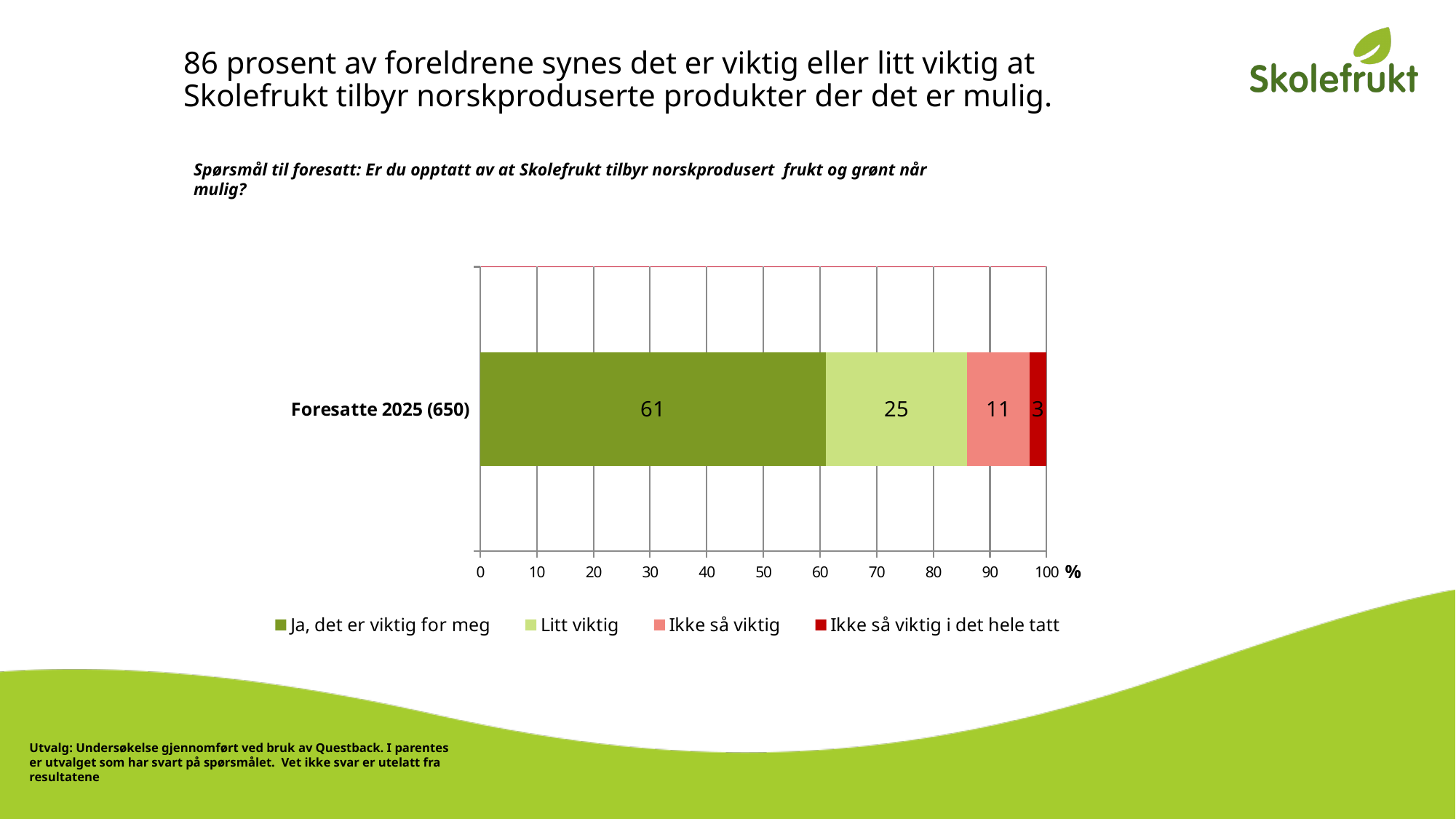
Which series has the lowest value in the Foresatte 2025 (650) bar? Ikke så viktig i det hele tatt What is the value for "Ikke så viktig i det hele tatt" for Foresatte 2025 (650)? 3 What is the total of the stacked bar for Foresatte 2025 (650)? 100 Which series has the highest value in the Foresatte 2025 (650) bar? Ja, det er viktig for meg What is the value for "Ja, det er viktig for meg" for Foresatte 2025 (650)? 61 What is the value for "Litt viktig" for Foresatte 2025 (650)? 25 What is the difference between the values for "Ja, det er viktig for meg" and "Litt viktig"? 36 What kind of chart is shown on the slide? Stacked bar chart What is the value for "Ikke så viktig" for Foresatte 2025 (650)? 11 Which is larger: the value for "Litt viktig" or the value for "Ikke så viktig"? Litt viktig How many series does the legend list? 4 What is the label of the category shown on the chart? Foresatte 2025 (650)